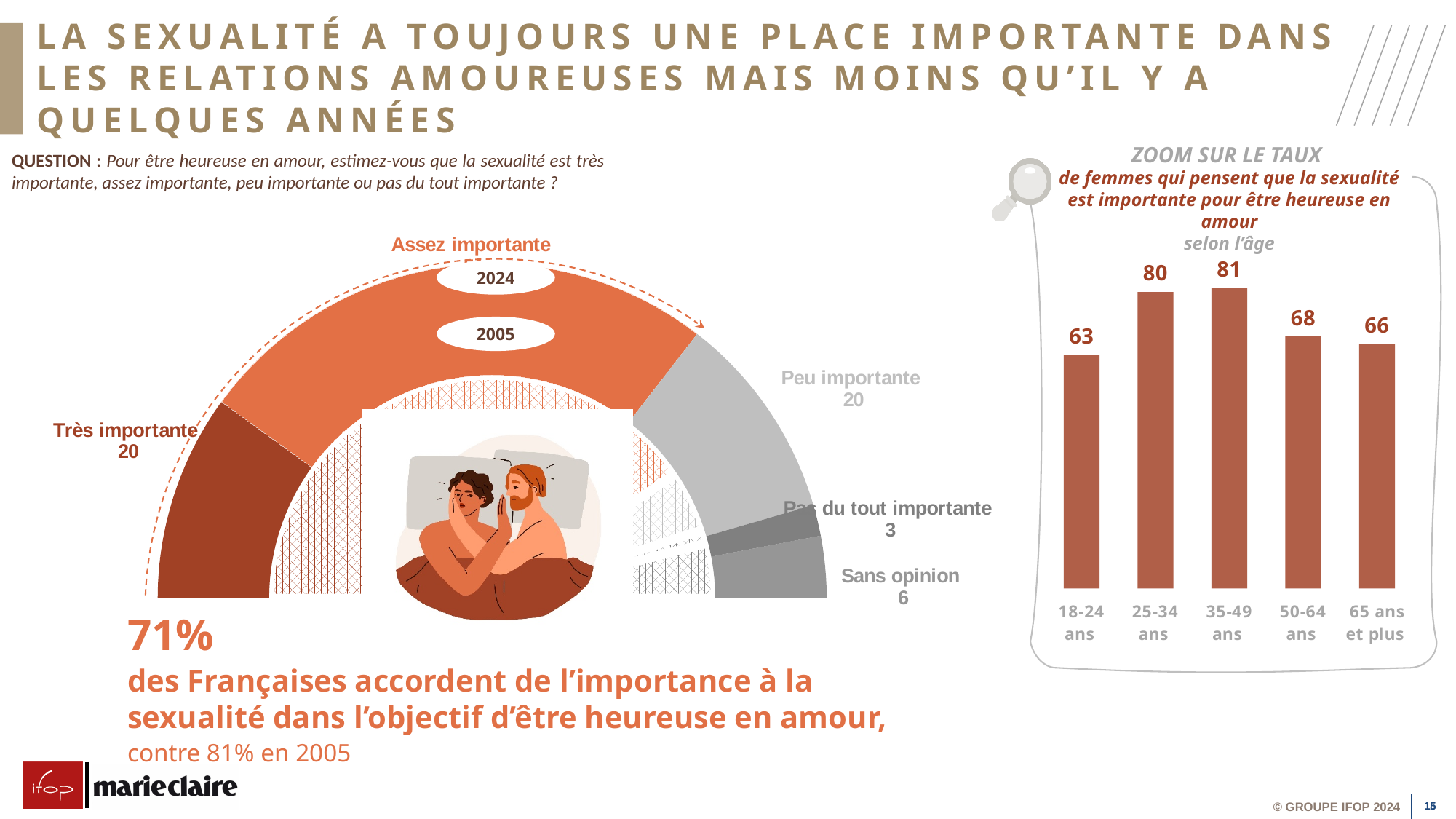
In the bar chart on the right, what is the value for 50-64 ans? 68 In the bar chart on the right, which age group has the highest value? 35-49 ans In the bar chart on the right, what is the difference between the values for 25-34 ans and 65 ans et plus? 14 In the semicircle chart on the left, what is the value for 'Très importante'? 20 In the semicircle chart on the left, which is larger: 'Sans opinion' or 'Pas du tout importante'? Sans opinion In the semicircle chart on the left, what is the difference between 'Peu importante' and 'Sans opinion'? 14 In the bar chart on the right (ZOOM SUR LE TAUX selon l'âge), what is the value for 18-24 ans? 63 What kind of chart is the chart on the right of the slide? Bar chart How many age groups are shown in the bar chart on the right? 5 In the bar chart on the right, which is larger: the value for 50-64 ans or the value for 65 ans et plus? 50-64 ans In the semicircle chart on the left, what is the value for 'Pas du tout importante'? 3 In the bar chart on the right, which age group has the lowest value? 18-24 ans